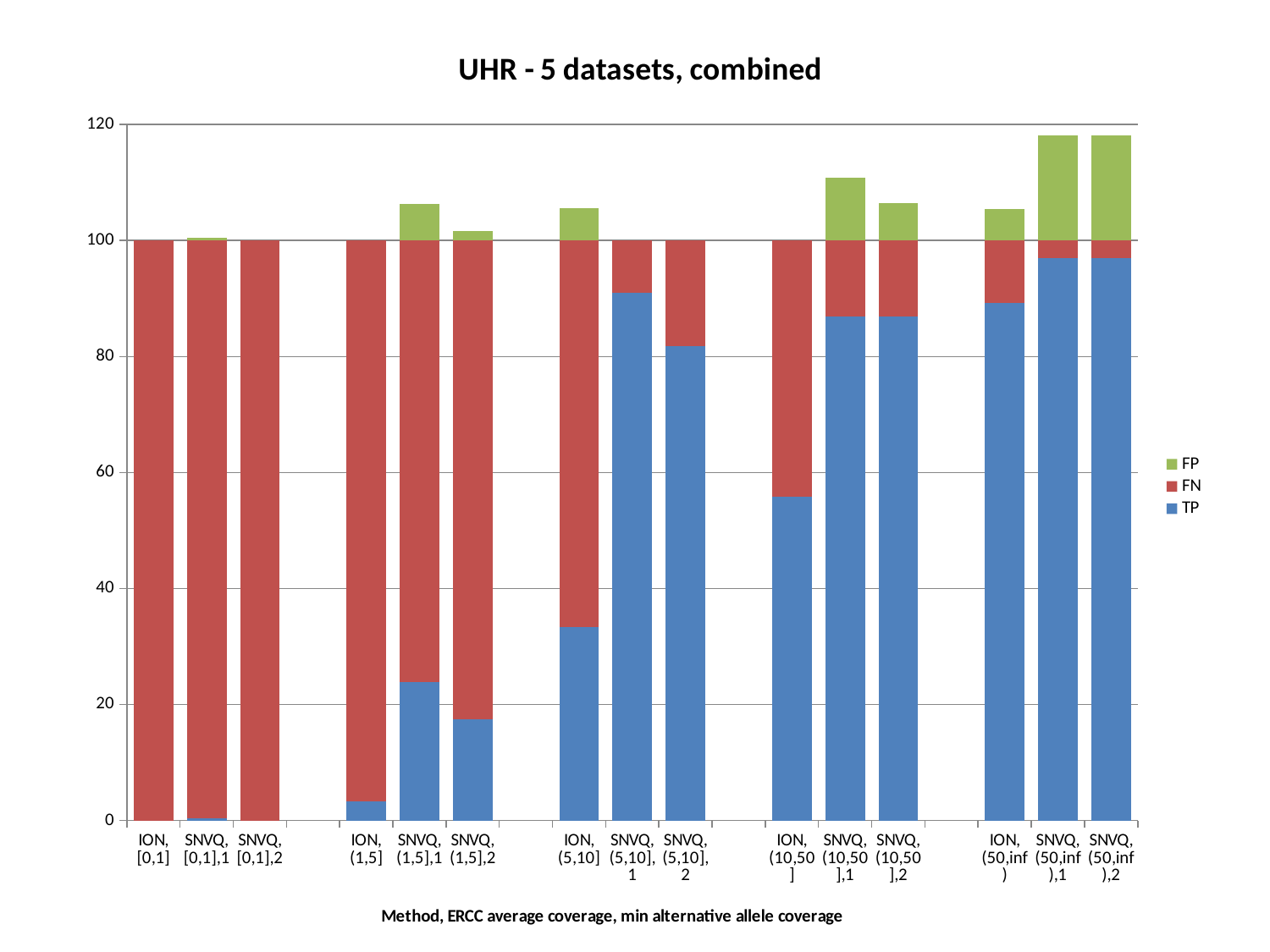
What kind of chart is shown on the slide? stacked bar chart What is the x-axis title of the chart? Method, ERCC average coverage, min alternative allele coverage Which has the larger TP value: "SNVQ, (5,10],1" or "SNVQ, (5,10],2"? SNVQ, (5,10],1 Among the ION bars, which category has the highest TP value? ION, (50,inf) Is the TP value for "ION, (5,10]" greater or less than 40? less Is the total height of the stacked bar for "SNVQ, (10,50],1" greater or less than 100? greater Does the TP value for the ION bars rise or fall as the ERCC average coverage bin increases from [0,1] to (50,inf)? rise Is the TP value for "ION, (10,50]" greater or less than 40? greater How many bars (categories) are plotted along the x axis? 15 What is the title of the chart? UHR - 5 datasets, combined How many series does the legend list? 3